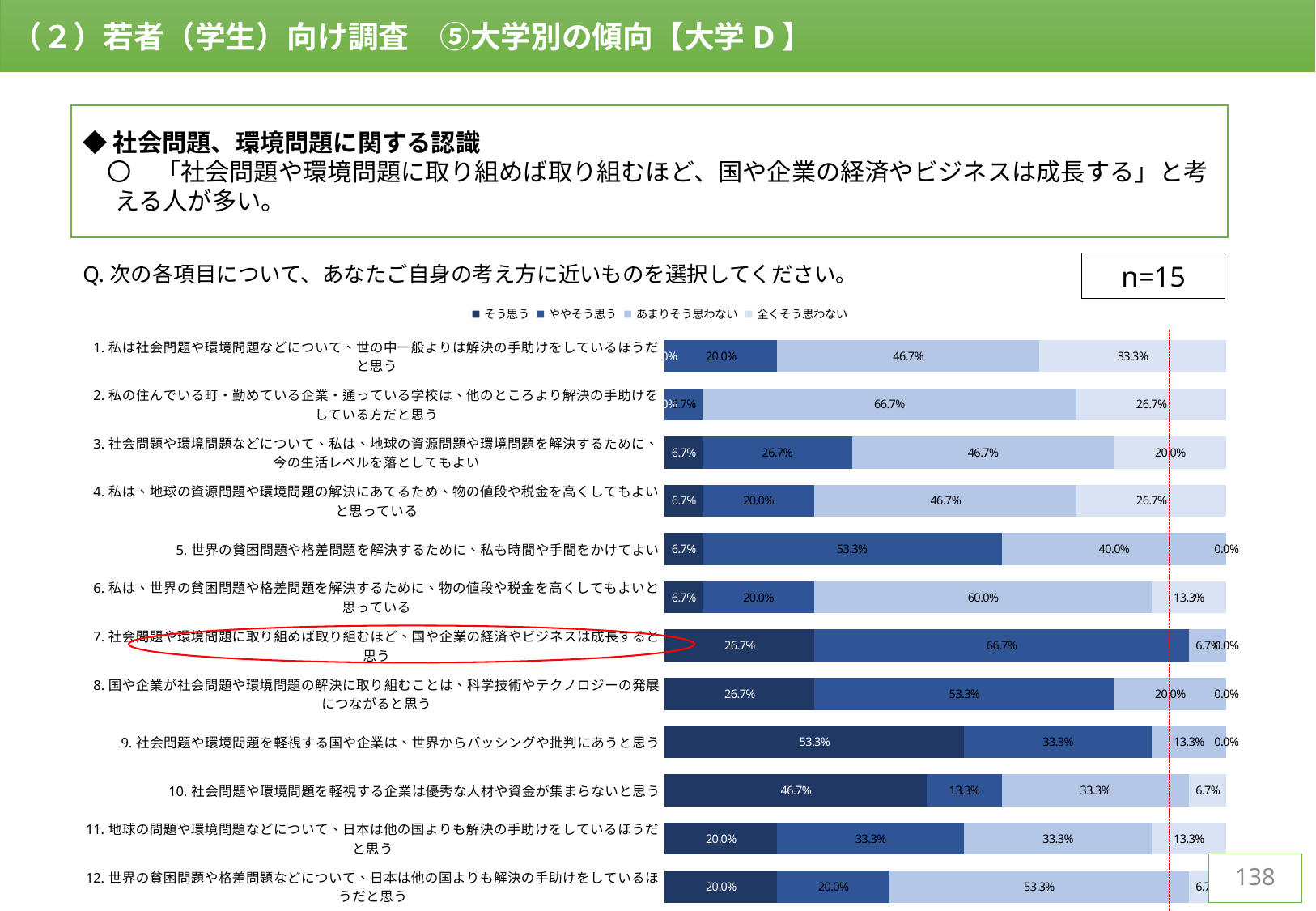
Which item has the highest そう思う value? 9. 社会問題や環境問題を軽視する国や企業は、世界からバッシングや批判にあうと思う What kind of chart is shown on the slide? Stacked bar chart What is the 全くそう思わない value for item 4 (私は、地球の資源問題や環境問題の解決にあてるため、物の値段や税金を高くしてもよいと思っている)? 26.7% What is the そう思う value for item 9 (社会問題や環境問題を軽視する国や企業は、世界からバッシングや批判にあうと思う)? 53.3% What is the あまりそう思わない value for item 6 (私は、世界の貧困問題や格差問題を解決するために、物の値段や税金を高くしてもよいと思っている)? 60.0% How many series does the chart legend list? 4 What is the difference between the そう思う values for item 9 and item 10? 6.6% Which is larger: the ややそう思う value for item 5 or for item 8? They are equal (53.3%) What is the ややそう思う value for item 7 (社会問題や環境問題に取り組めば取り組むほど、国や企業の経済やビジネスは成長すると思う)? 66.7% How many items (categories) are plotted in the chart? 12 What is the sample size (n) shown on the slide? n=15 Which item has the highest あまりそう思わない value? 2. 私の住んでいる町・勤めている企業・通っている学校は、他のところより解決の手助けをしている方だと思う